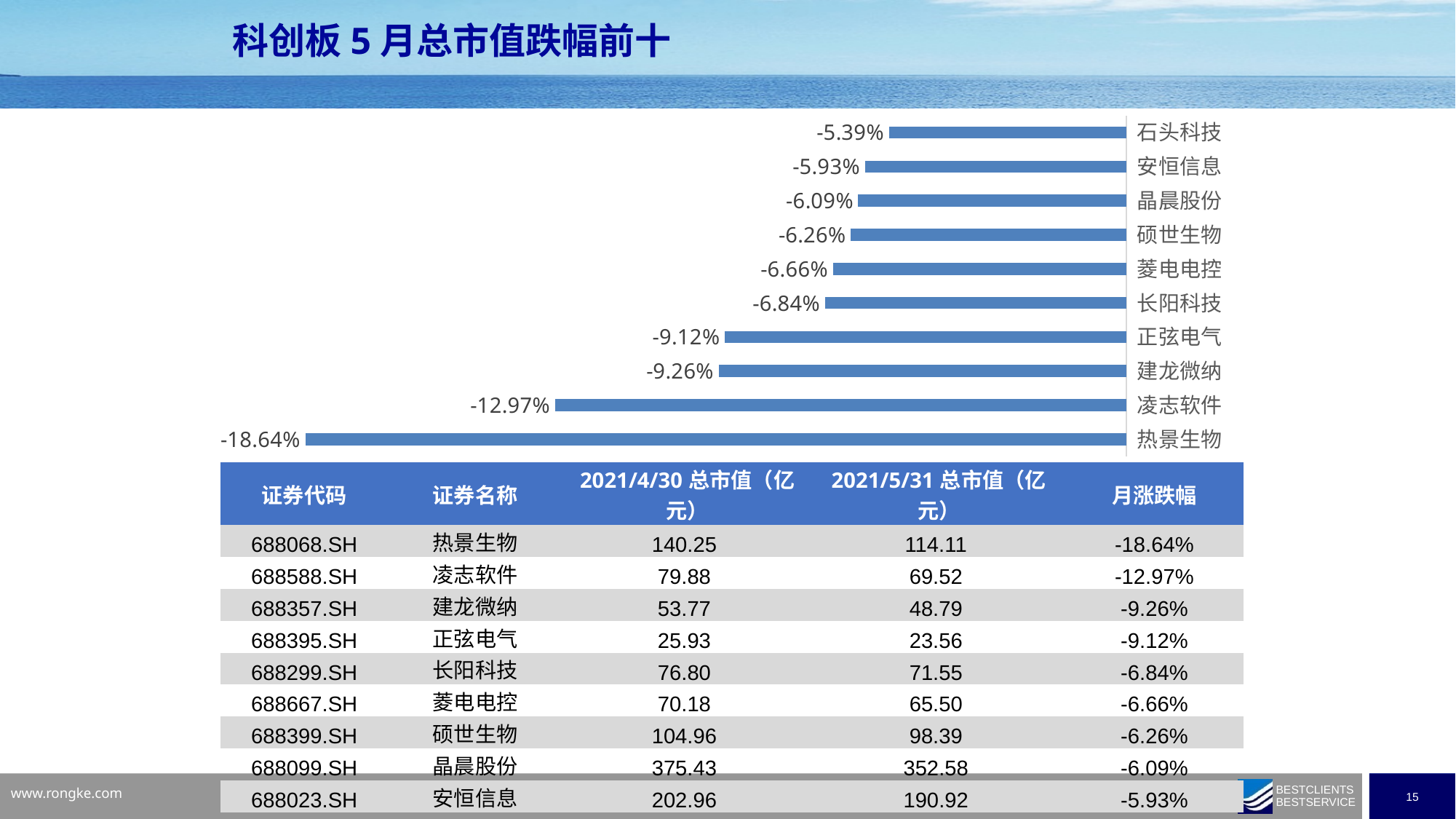
What is the difference in percentage points between the values for 热景生物 and 凌志软件? 5.67 percentage points Which company has the largest decline (lowest value) in the bar chart? 热景生物 How many companies are shown in the bar chart? 10 What is the value shown for 凌志软件 in the bar chart? -12.97% What kind of chart is shown on the slide? Bar chart What is the value shown for 石头科技 in the bar chart? -5.39% What is the difference in percentage points between the values for 建龙微纳 and 正弦电气? 0.14 percentage points What is the value shown for 正弦电气 in the bar chart? -9.12% What is the value shown for 热景生物 in the bar chart? -18.64% Which has a larger decline, 菱电电控 or 硕世生物? 菱电电控 What is the title of the slide containing the chart? 科创板 5 月总市值跌幅前十 Which company has the smallest decline (highest value) in the bar chart? 石头科技